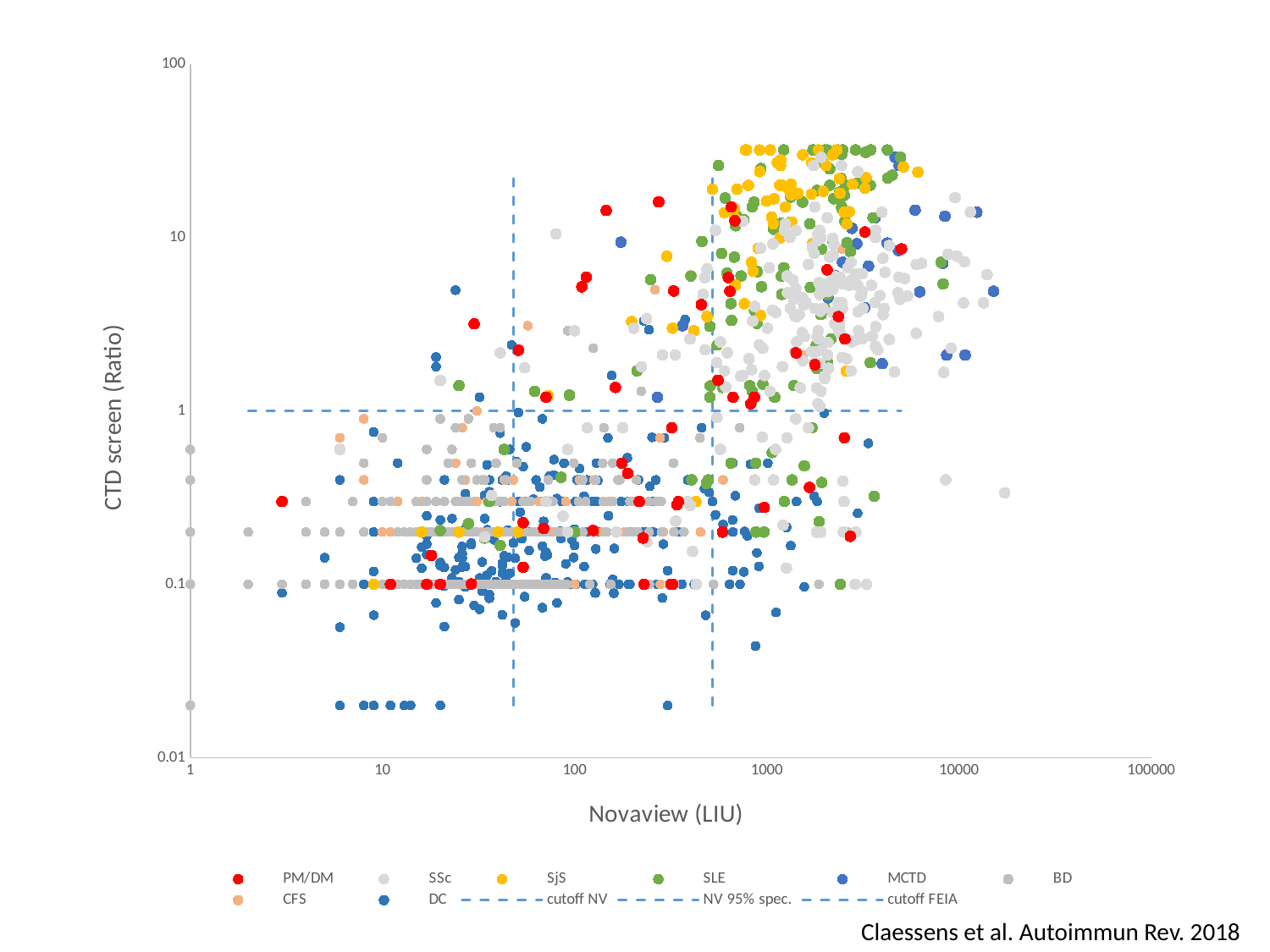
Which source is cited for the chart? Claessens et al. Autoimmun Rev. 2018 How many entries does the legend list in total, including the cutoff lines? 11 What is the label of the x axis? Novaview (LIU) Which legend series is plotted in yellow? SjS What kind of chart is shown on the slide? scatter chart What is the highest tick value shown on the x axis? 100000 Are the dark blue DC points mostly above or below the horizontal dashed line at 1? below Are the yellow SjS points mostly above or below the horizontal dashed line at 1? above At which y-axis value is the horizontal dashed cutoff line drawn? 1 What is the lowest tick value shown on the y axis? 0.01 How many vertical dashed cutoff lines are drawn on the chart? 2